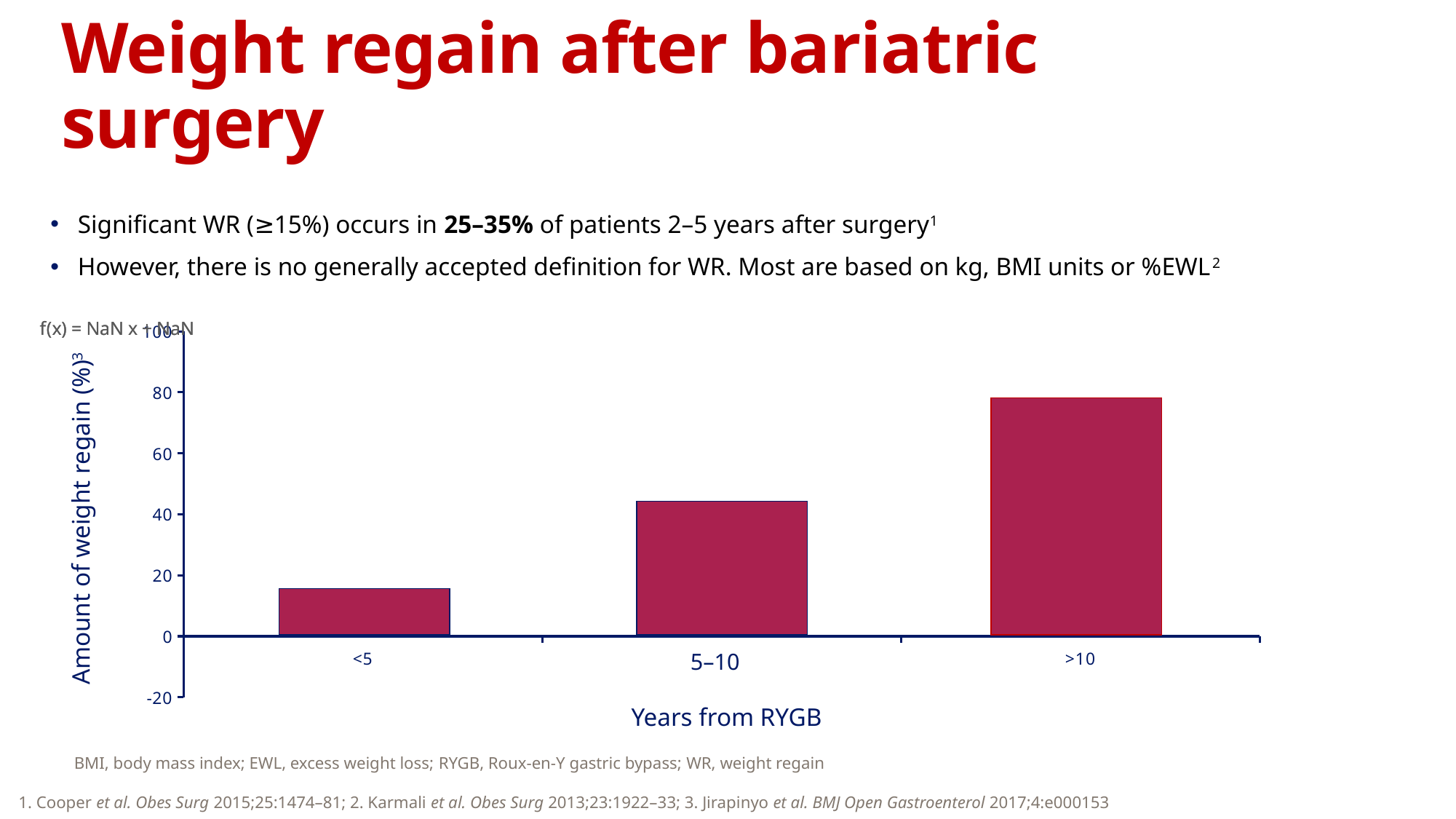
How many categories are plotted on the x axis of the chart? 3 Is the value for 5–10 years greater or less than 40? greater Which category has the lowest amount of weight regain? <5 Which has a larger amount of weight regain, 5–10 years or <5 years? 5–10 Do the values rise or fall as years from RYGB increase along the x axis? rise What is the label of the y axis of the chart? Amount of weight regain (%) What kind of chart is shown on the slide? bar chart Which category has the highest amount of weight regain? >10 Is the value for <5 years greater or less than 20? less What is the label of the x axis of the chart? Years from RYGB Is the value for >10 years greater or less than 60? greater